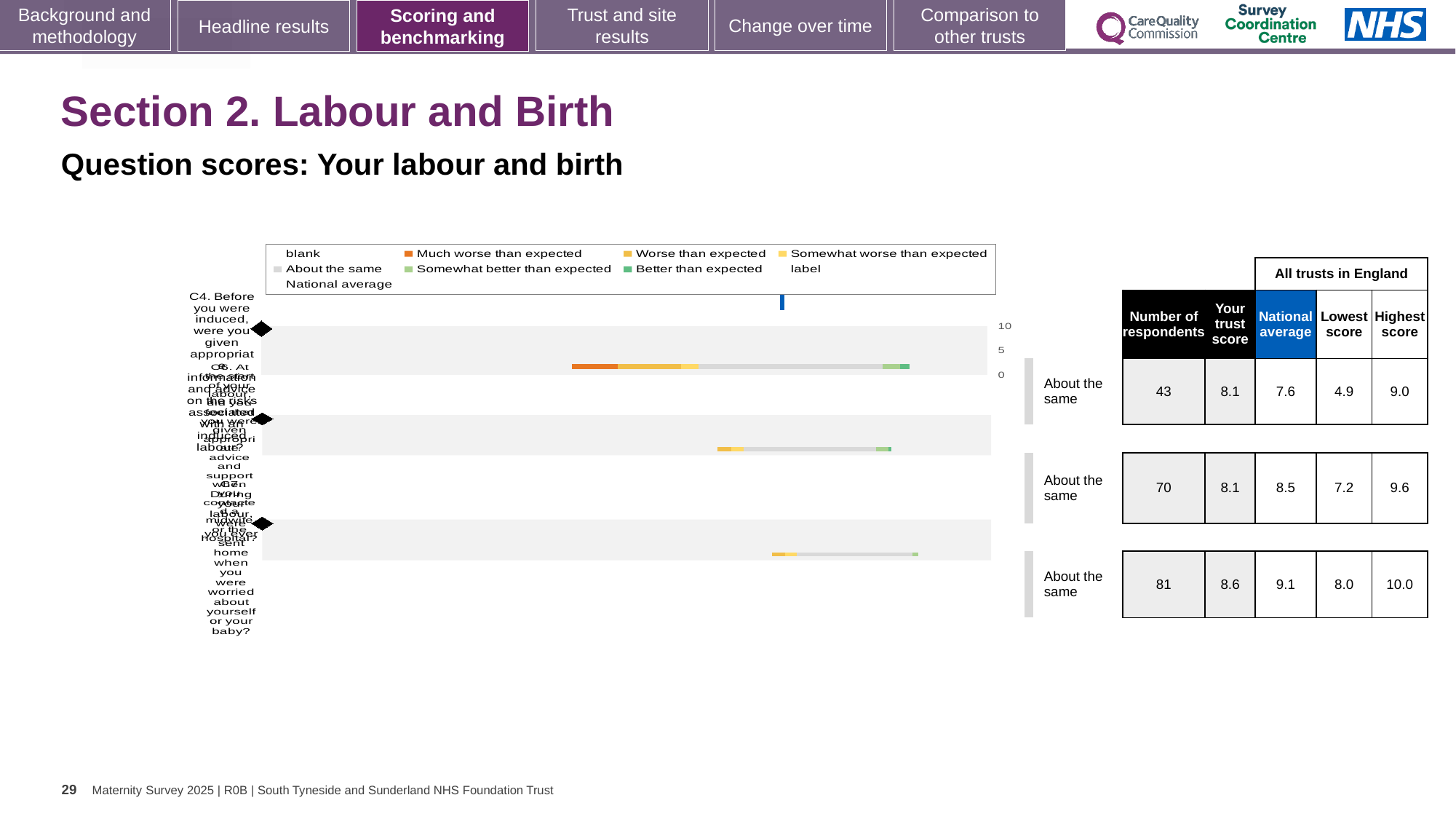
How many horizontal bars are plotted in the chart? 3 What kind of chart is shown on the slide? bar chart In the table next to the chart, what is the difference between the highest score and the lowest score in the second row? 2.4 Which legend entry is shown in dark orange? Much worse than expected What is the highest value shown on the chart's axis? 10 In the table next to the chart, what is the number of respondents for the first row? 43 In the table next to the chart, is the trust score in the first row larger or smaller than the national average in that row? larger In the table next to the chart, which row has the highest 'Your trust score'? the third row (8.6) What benchmark label is given for each of the three rows beside the chart? About the same In the table next to the chart, what is the national average for the third row? 9.1